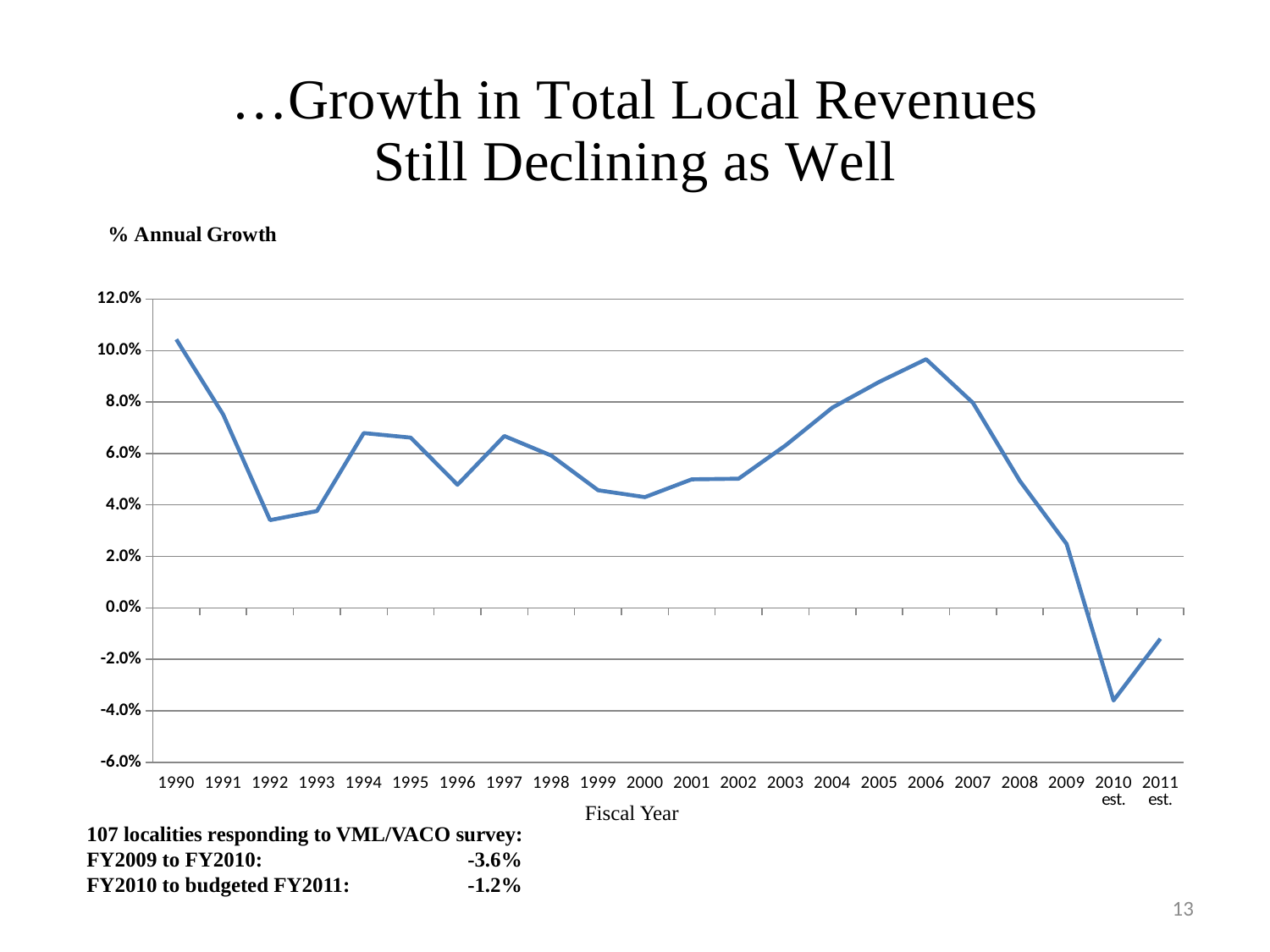
Which fiscal year has the highest % annual growth? 1990 What kind of chart is shown on the slide? Line chart Is the value for 2006 greater or less than 8.0%? greater Which fiscal year has the lowest % annual growth? 2010 est. What is the % annual growth value for 2010 est.? -3.6% By how many percentage points does the value for 2011 est. differ from the value for 2010 est.? 2.4 Is the value for 1992 greater or less than 4.0%? less Is the value for 1990 greater or less than 10.0%? greater Which has the higher % annual growth, 1994 or 1996? 1994 What is the % annual growth value for 2011 est.? -1.2% How many fiscal years are plotted on the x axis? 22 Do the values rise or fall from 2006 to 2010 est.? Fall